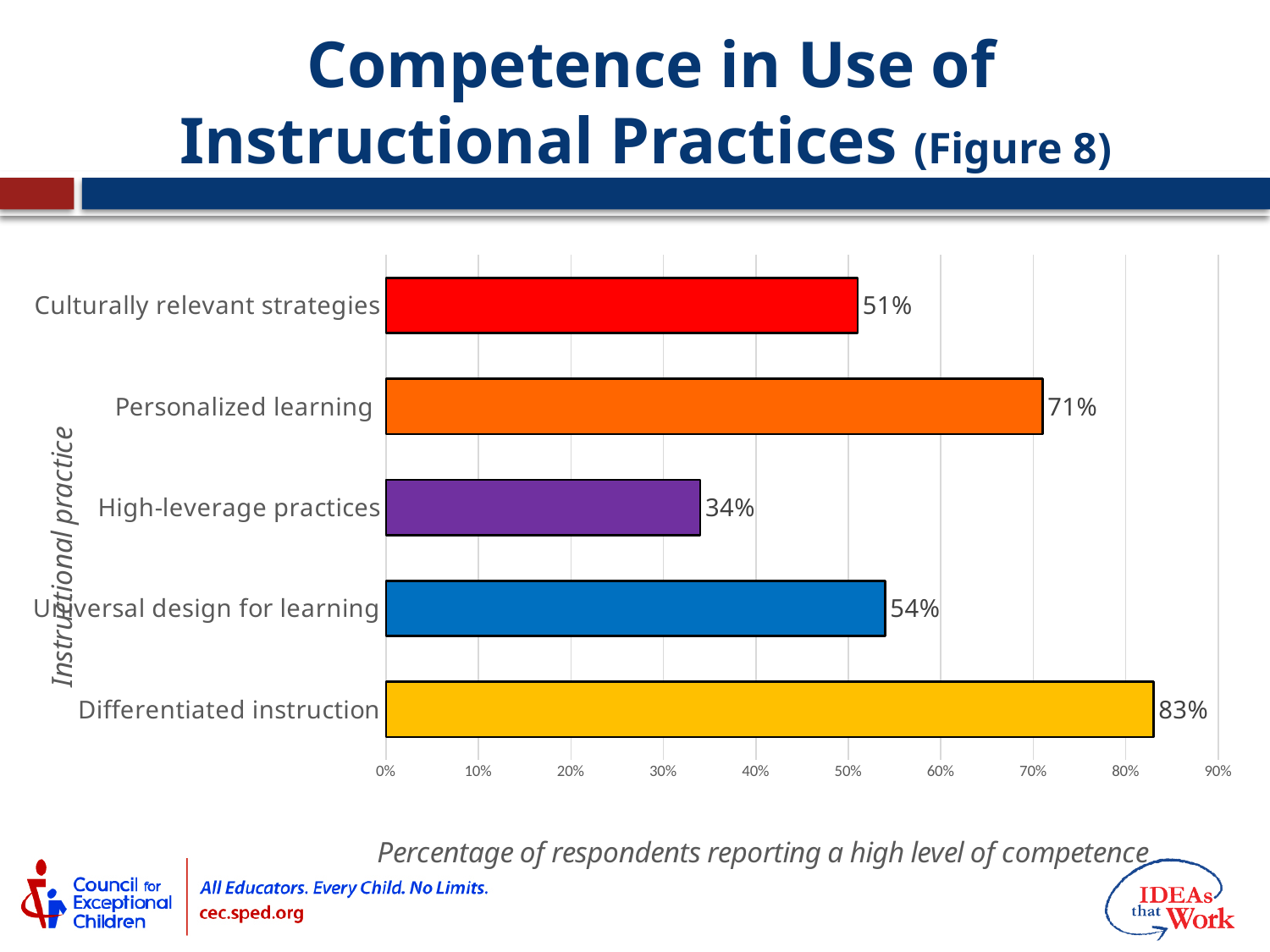
What is the value shown for High-leverage practices? 34% Is the value for Culturally relevant strategies greater or less than 60%? less What kind of chart is shown on the slide? Bar chart What is the value shown for Personalized learning? 71% How many instructional practices are shown in the chart? 5 Which instructional practice has the lowest percentage? High-leverage practices Which instructional practice has the highest percentage? Differentiated instruction What is the difference between the values for Universal design for learning and Culturally relevant strategies? 3% What is the label of the vertical axis? Instructional practice What is the difference between the values for Differentiated instruction and High-leverage practices? 49% Which is larger, the value for Personalized learning or the value for Universal design for learning? Personalized learning What percentage of respondents reported a high level of competence in Differentiated instruction? 83%